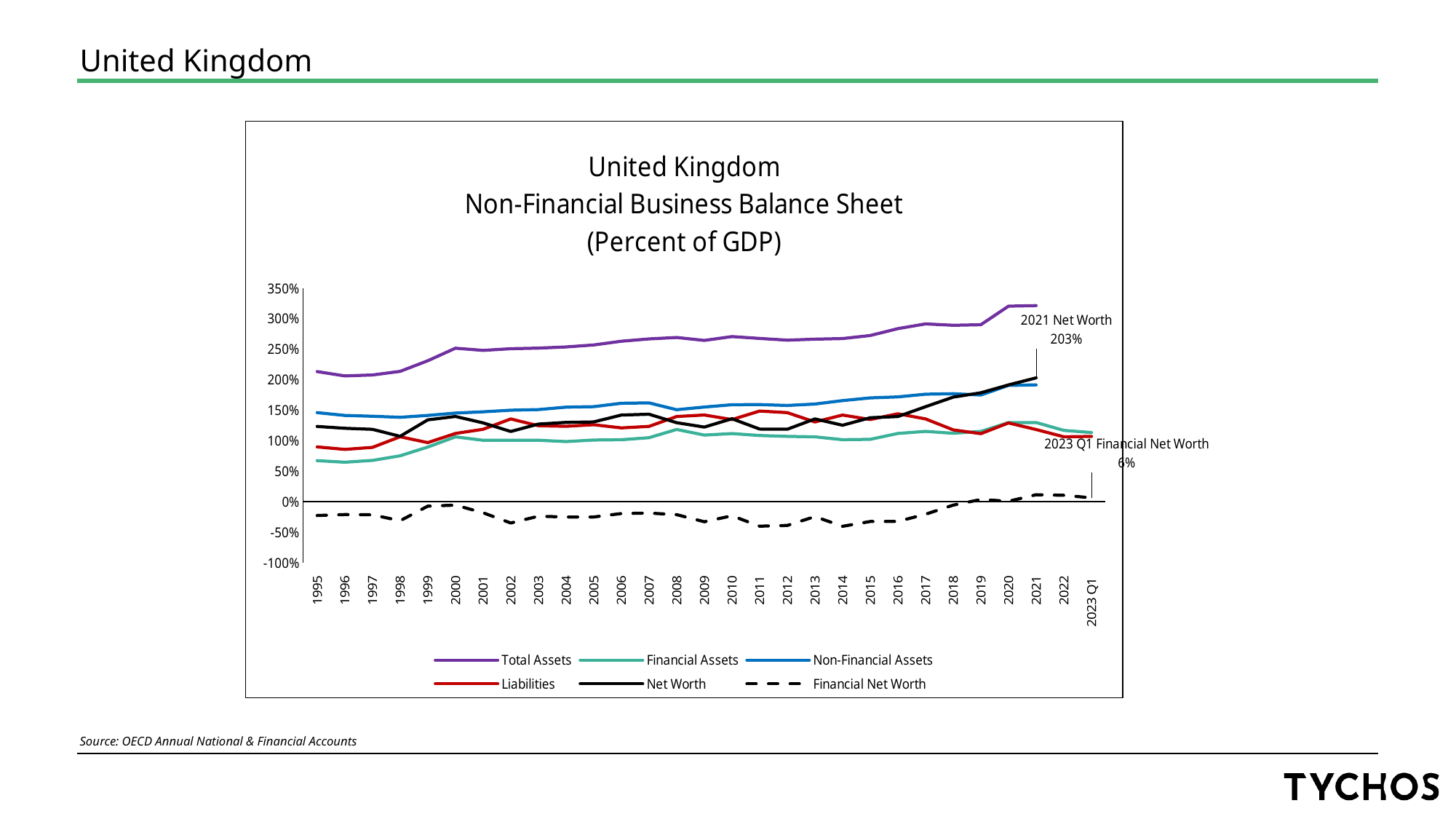
Is the value for Financial Net Worth in 2011 greater or less than 0%? less What kind of chart is shown on the slide? line chart Which series has the lowest value in 2021? Financial Net Worth How many series does the legend list? 6 Is the value for Financial Assets in 1995 greater or less than 100%? less Which series is drawn with a dashed line? Financial Net Worth What is the Net Worth value for 2021 according to the annotation? 203% Which series has the highest value in 2021? Total Assets Is the value for Total Assets in 2021 greater or less than 300%? greater What is the Financial Net Worth value for 2023 Q1 according to the annotation? 6% In 2010, which is larger: Net Worth or Financial Net Worth? Net Worth Does the Total Assets series generally rise or fall from 1995 to 2021? rise